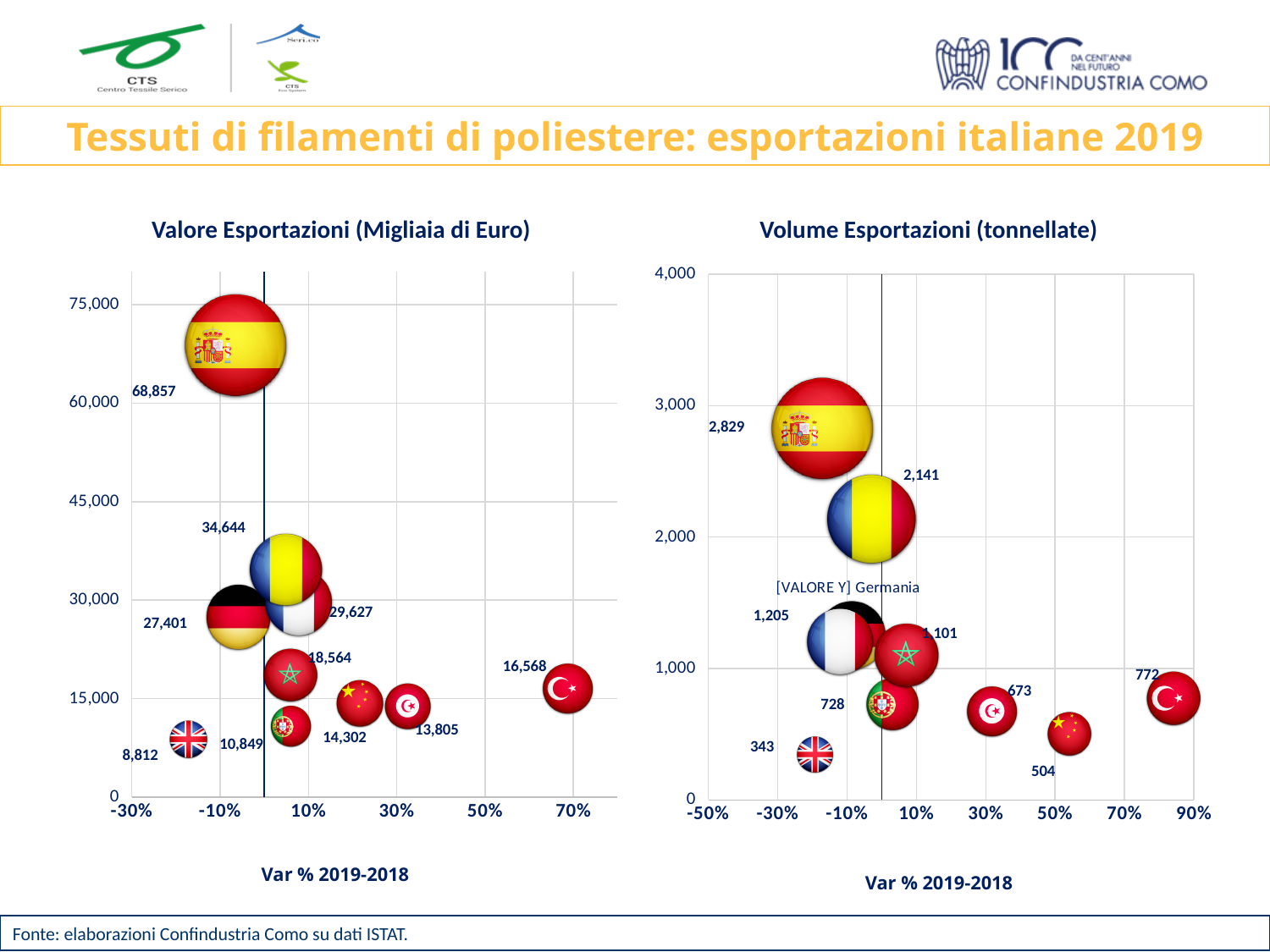
In the 'Valore Esportazioni (Migliaia di Euro)' chart, is the x-axis position of the bubble labeled 16,568 greater or less than 50%? greater In the 'Volume Esportazioni (tonnellate)' chart, what is the lowest value labeled on a bubble? 343 In the 'Volume Esportazioni (tonnellate)' chart, what is the difference between the two largest labeled values, 2,829 and 2,141? 688 In the 'Valore Esportazioni (Migliaia di Euro)' chart, what is the difference between the two largest labeled values, 68,857 and 34,644? 34,213 In the 'Valore Esportazioni (Migliaia di Euro)' chart, what is the lowest value labeled on a bubble? 8,812 In the 'Valore Esportazioni (Migliaia di Euro)' chart, what is the highest value labeled on a bubble? 68,857 How many bubbles are plotted in the 'Valore Esportazioni (Migliaia di Euro)' chart? 10 What kind of chart is used on this slide for both 'Valore Esportazioni' and 'Volume Esportazioni'? Bubble chart How many bubbles are plotted in the 'Volume Esportazioni (tonnellate)' chart? 10 In the 'Volume Esportazioni (tonnellate)' chart, what is the highest value labeled on a bubble? 2,829 What is the title of the chart on the right side of the slide? Volume Esportazioni (tonnellate) What is the x-axis label shown under both charts? Var % 2019-2018